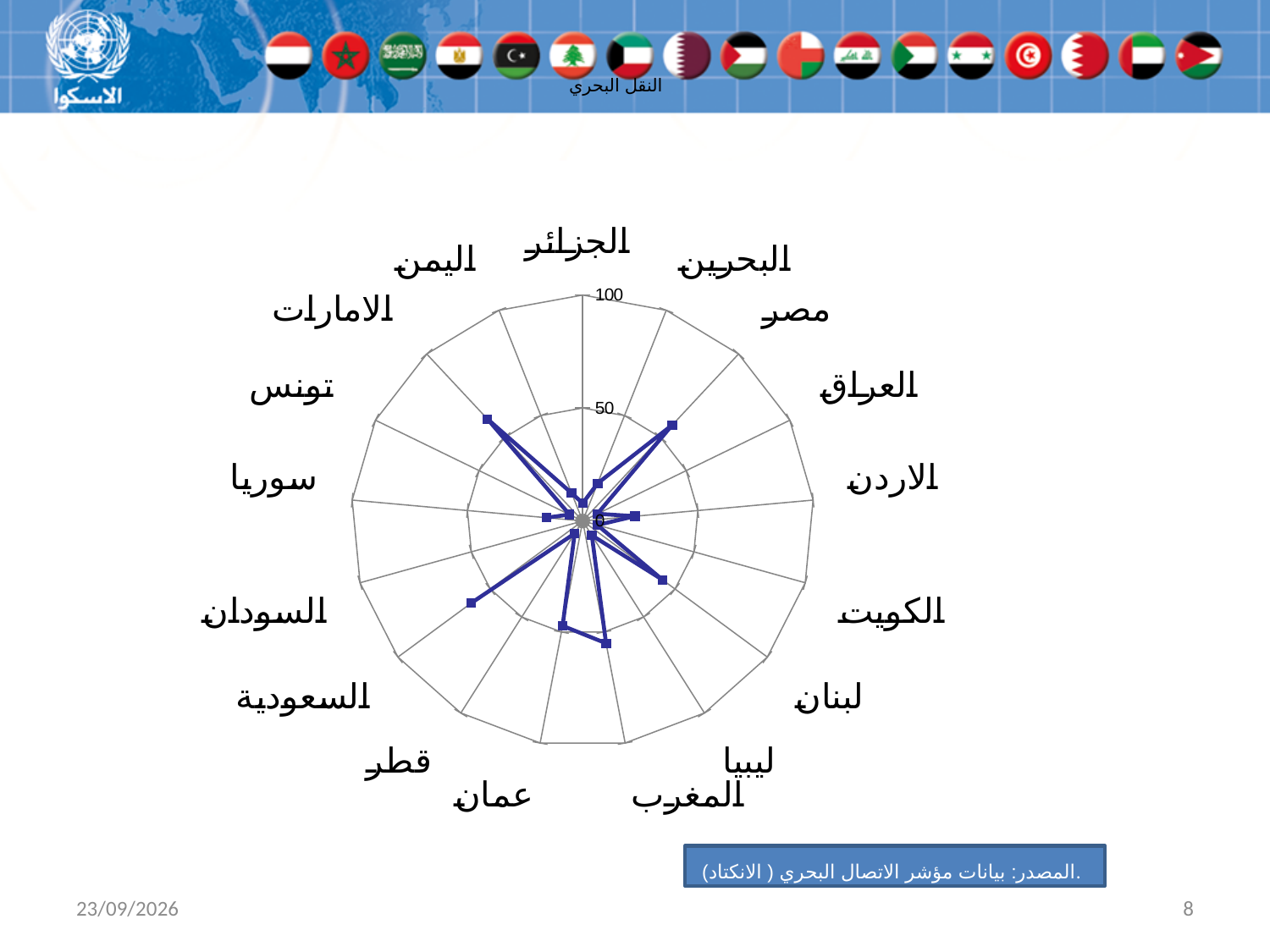
What is the maximum value shown on the radar chart's axis? 100 Is the value for الجزائر greater or less than 50? less Is the value for سوريا greater or less than 50? less Is the value for مصر greater or less than 100? less Which has the larger value, الامارات or اليمن? الامارات Which has the larger value, السعودية or الجزائر? السعودية How many countries (categories) are plotted on the radar chart? 17 What kind of chart is shown on the slide? radar chart